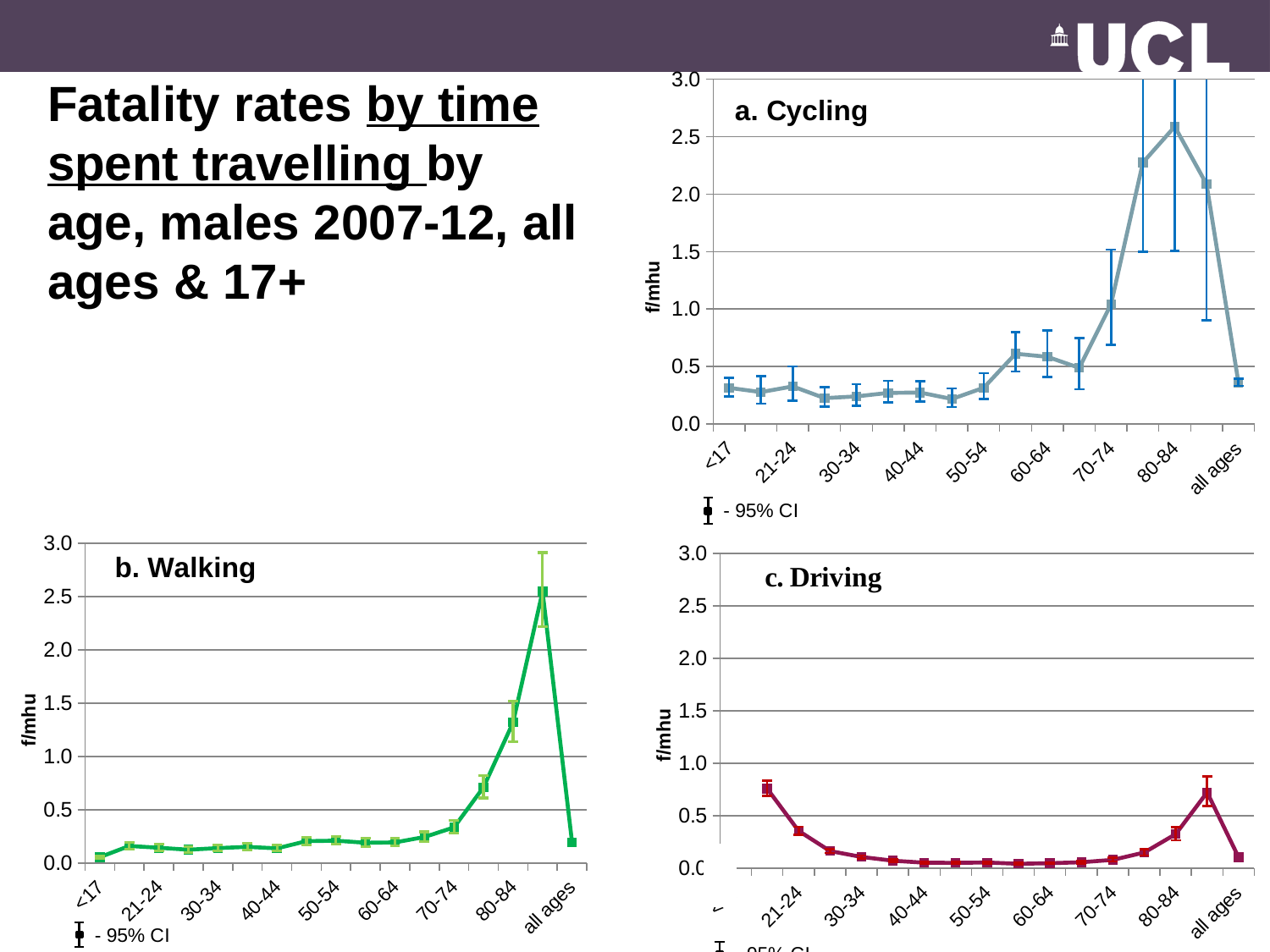
In the 'b. Walking' chart, do the values rise or fall from 70-74 to 80-84? rise In the 'a. Cycling' chart, is the value for 'all ages' greater or less than 0.5? less What is the y-axis label on the 'b. Walking' chart? f/mhu In the 'b. Walking' chart, is the value for 70-74 greater or less than 0.5? less What kind of chart is the 'a. Cycling' chart? line chart In the 'a. Cycling' chart, is the value for 80-84 greater or less than 2.0? greater Comparing the 'all ages' values, which chart shows the larger value: 'a. Cycling' or 'c. Driving'? a. Cycling In the 'a. Cycling' chart, which labelled age group has the highest fatality rate? 80-84